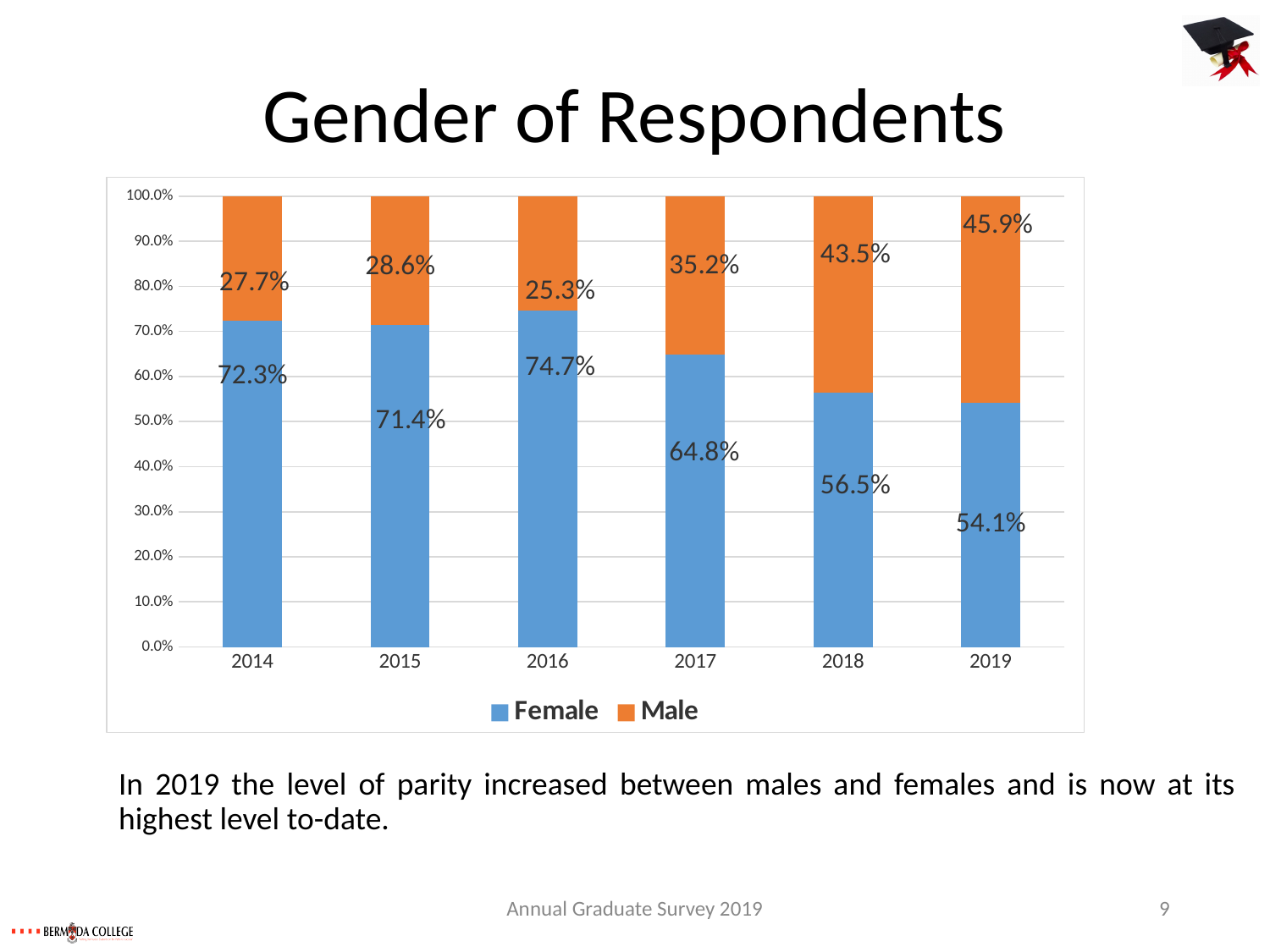
How many series does the legend list? 2 What kind of chart is shown? Stacked bar chart In which year is the Male share lowest? 2016 What is the Male value for 2019? 45.9% What is the difference between the Female and Male values in 2017? 29.6% How many years are shown on the x axis? 6 In which year is the Female share lowest? 2019 In which year is the Male share highest? 2019 What is the Female value for 2016? 74.7% What is the Female value for 2018? 56.5% Does the Male share rise or fall from 2016 to 2019? Rise Which is larger, the Male value for 2015 or the Male value for 2018? 2018